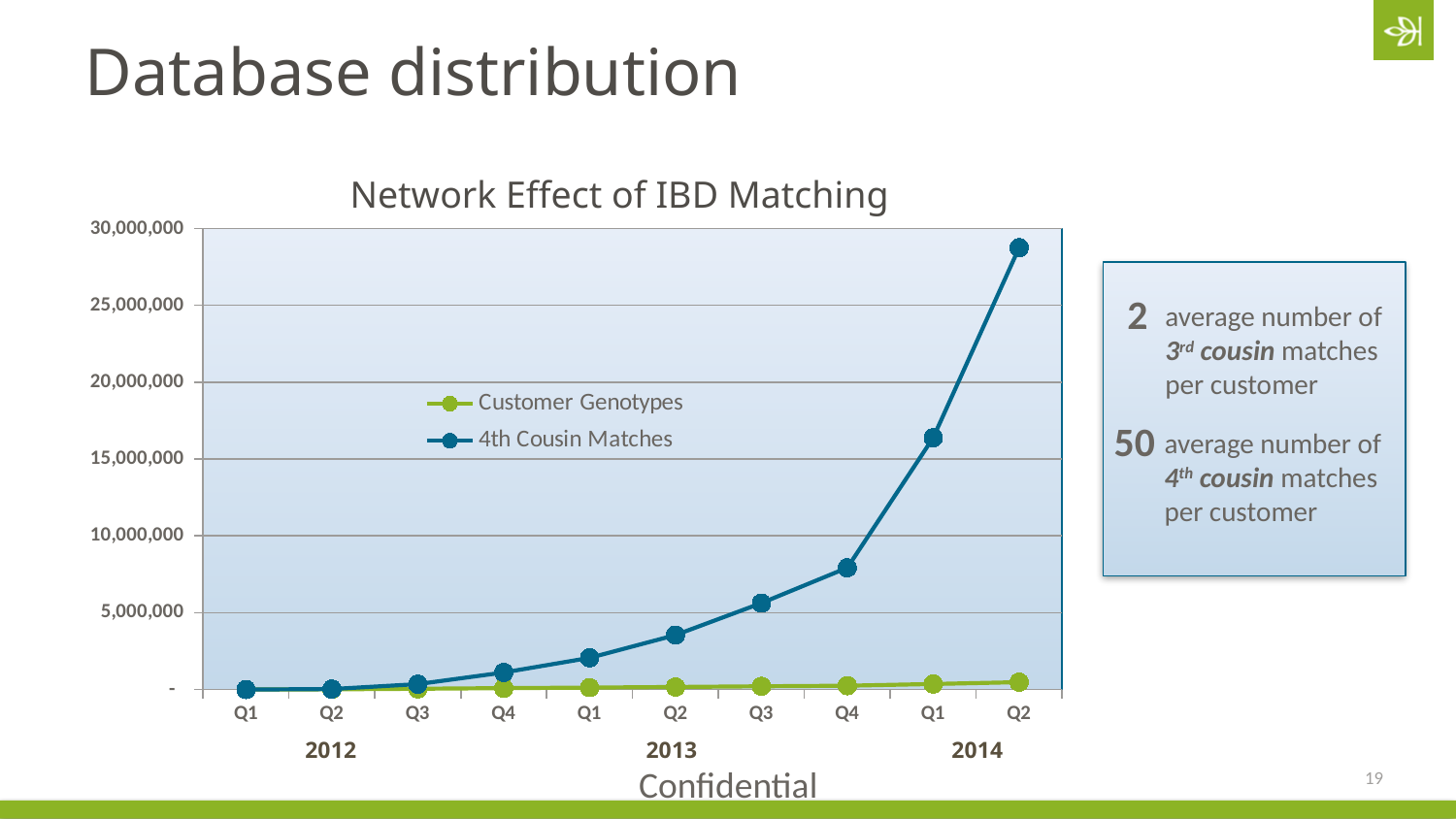
Does the 4th Cousin Matches series rise or fall from Q1 2012 to Q2 2014? rise How many series does the chart's legend list? 2 In Q2 2014, which series has the larger value, Customer Genotypes or 4th Cousin Matches? 4th Cousin Matches Is the value of 4th Cousin Matches in Q2 2014 greater or less than 25,000,000? greater What kind of chart is shown on the slide? line chart What is the title of the chart? Network Effect of IBD Matching Is the value of 4th Cousin Matches in Q4 2013 greater or less than 10,000,000? less Which colour is used for the Customer Genotypes series? green In which quarter does the 4th Cousin Matches series reach its highest value? Q2 2014 How many quarterly data points are plotted along the x axis? 10 Is the value of 4th Cousin Matches in Q1 2014 greater or less than 15,000,000? greater